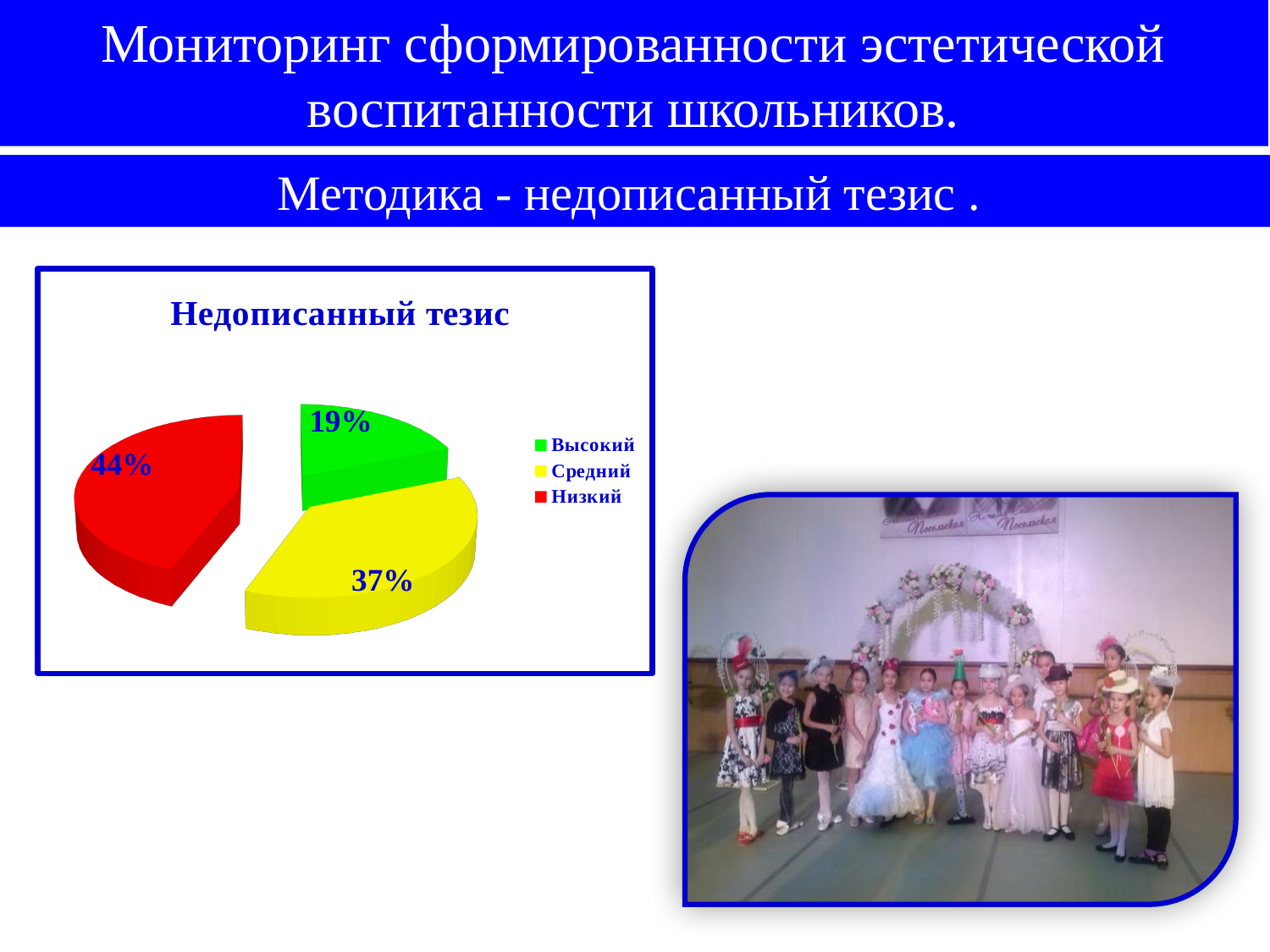
Which category has the largest share of the pie? Низкий What is the difference between the shares for Низкий and Средний? 7% What is the difference between the shares for Низкий and Высокий? 25% Which category has the smallest share of the pie? Высокий What percentage is shown for Средний? 37% What percentage is shown for Высокий? 19% What is the title of the chart? Недописанный тезис What percentage is shown for Низкий? 44% What colour is the slice for Средний? yellow Which is larger, the share for Средний or the share for Высокий? Средний What type of chart is shown on the slide? pie chart How many slices does the pie chart have? 3